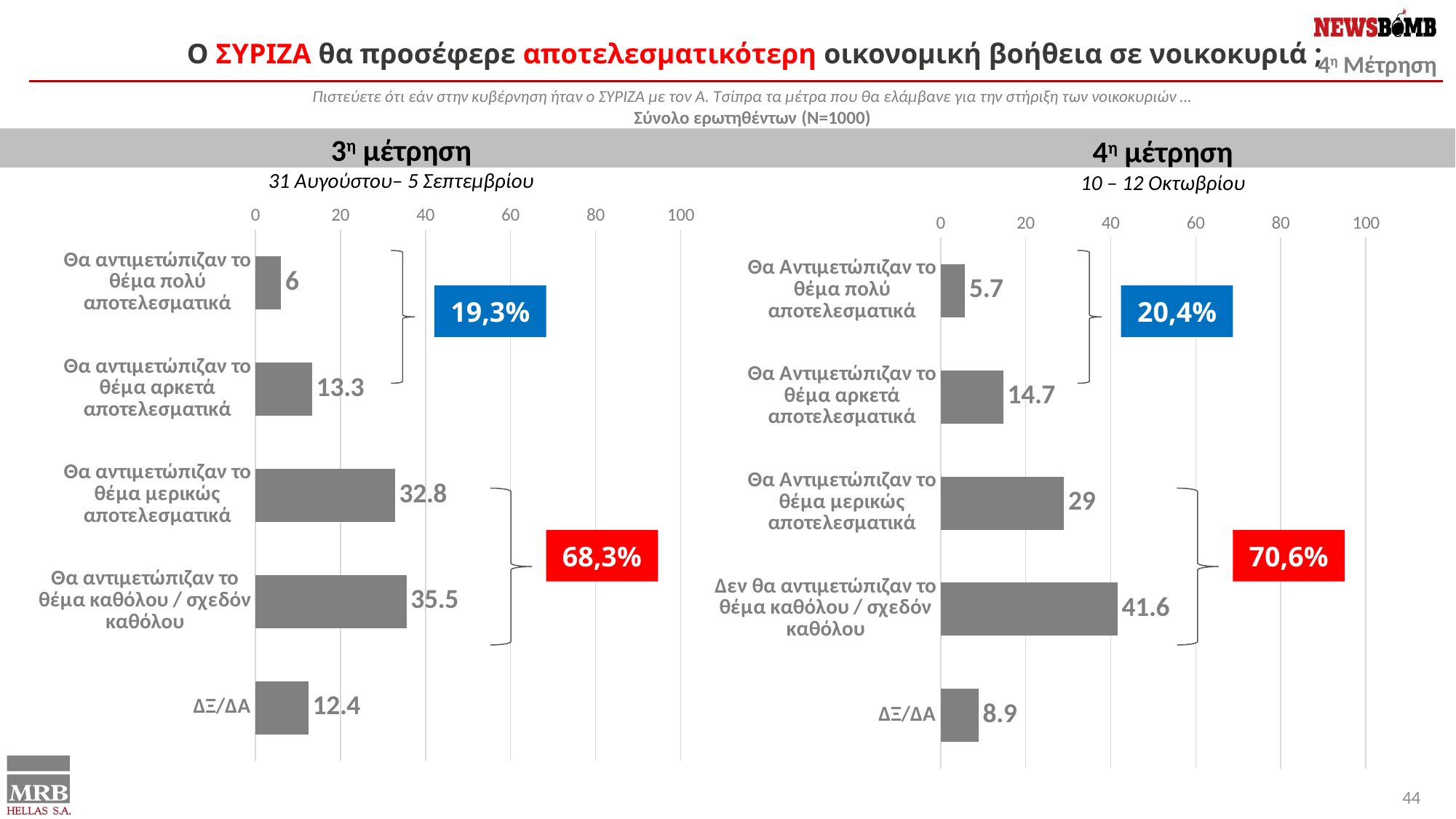
What kind of chart is the 4η μέτρηση chart? Bar chart In the 3η μέτρηση chart, which category has the highest value? Θα αντιμετώπιζαν το θέμα καθόλου / σχεδόν καθόλου In the 4η μέτρηση chart, which category has the lowest value? Θα Αντιμετώπιζαν το θέμα πολύ αποτελεσματικά In the 4η μέτρηση chart, what is the value for ΔΞ/ΔΑ? 8.9 In the 4η μέτρηση chart, what is the value for 'Δεν θα αντιμετώπιζαν το θέμα καθόλου / σχεδόν καθόλου'? 41.6 How many categories are shown in the 3η μέτρηση chart? 5 In the 3η μέτρηση chart, what is the difference between 'Θα αντιμετώπιζαν το θέμα καθόλου / σχεδόν καθόλου' and 'Θα αντιμετώπιζαν το θέμα μερικώς αποτελεσματικά'? 2.7 In the 4η μέτρηση chart, what is the difference between 'Δεν θα αντιμετώπιζαν το θέμα καθόλου / σχεδόν καθόλου' and 'Θα Αντιμετώπιζαν το θέμα μερικώς αποτελεσματικά'? 12.6 Which is larger: ΔΞ/ΔΑ in the 3η μέτρηση chart or ΔΞ/ΔΑ in the 4η μέτρηση chart? 3η μέτρηση In the 3η μέτρηση chart, what is the value for 'Θα αντιμετώπιζαν το θέμα πολύ αποτελεσματικά'? 6 In the 4η μέτρηση chart, what combined percentage is shown in the red box? 70,6% In the 4η μέτρηση chart, is the value for 'Δεν θα αντιμετώπιζαν το θέμα καθόλου / σχεδόν καθόλου' greater or less than 40? greater